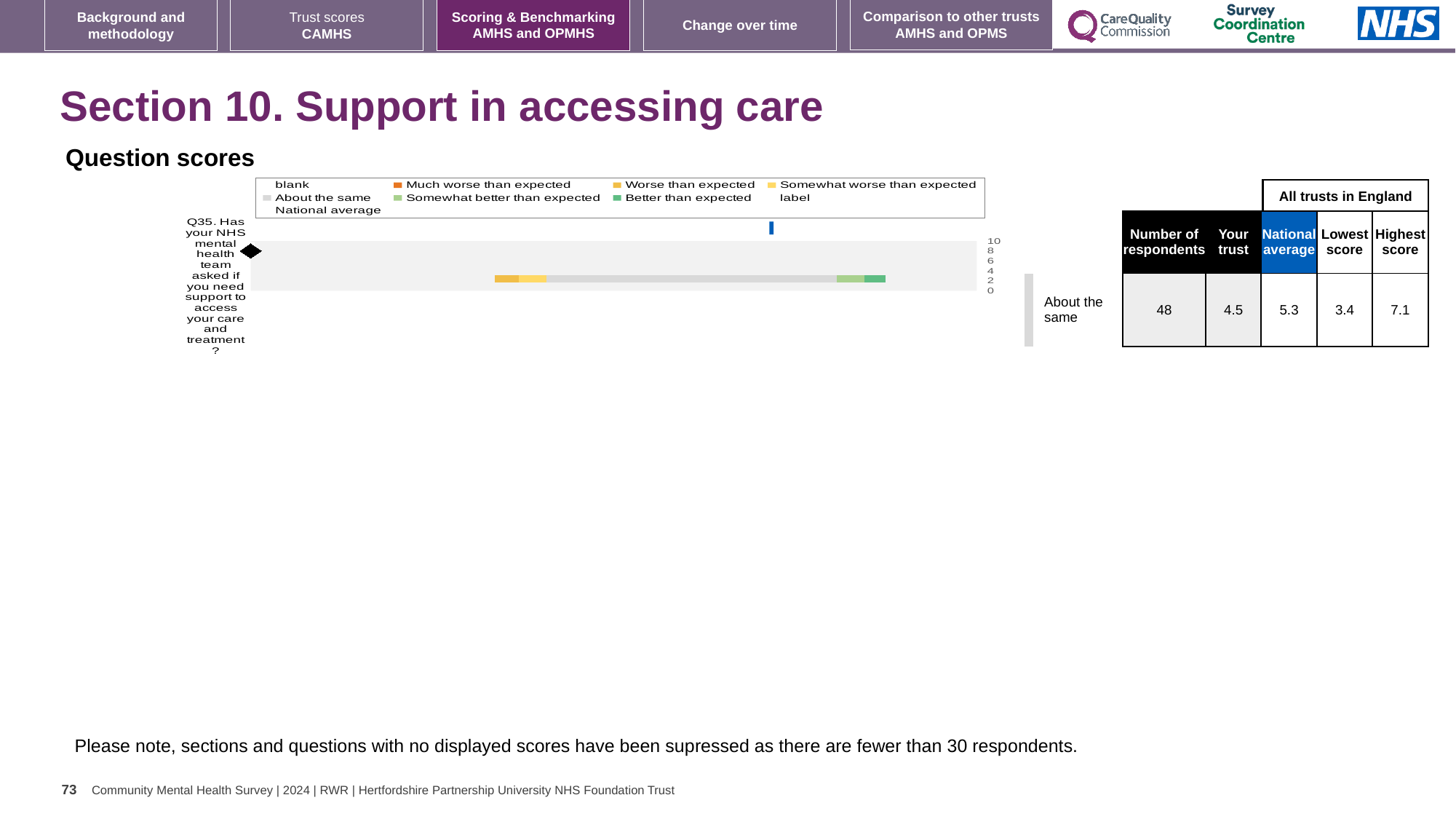
What benchmark category is shown next to the bar for Q35? About the same What is the "Your trust" score for Q35? 4.5 What is the maximum value shown on the score axis of the Question scores chart? 10 How many questions (categories) are plotted in the Question scores chart? 1 Which question is plotted in the Question scores chart? Q35. Has your NHS mental health team asked if you need support to access your care and treatment? How many respondents are listed for Q35? 48 What is the lowest score among all trusts in England for Q35? 3.4 Which is larger for Q35, the "Your trust" score or the national average? National average What is the difference between the highest score and the lowest score for Q35? 3.7 What is the highest score among all trusts in England for Q35? 7.1 What is the national average score for Q35? 5.3 What kind of chart is shown under "Question scores"? bar chart